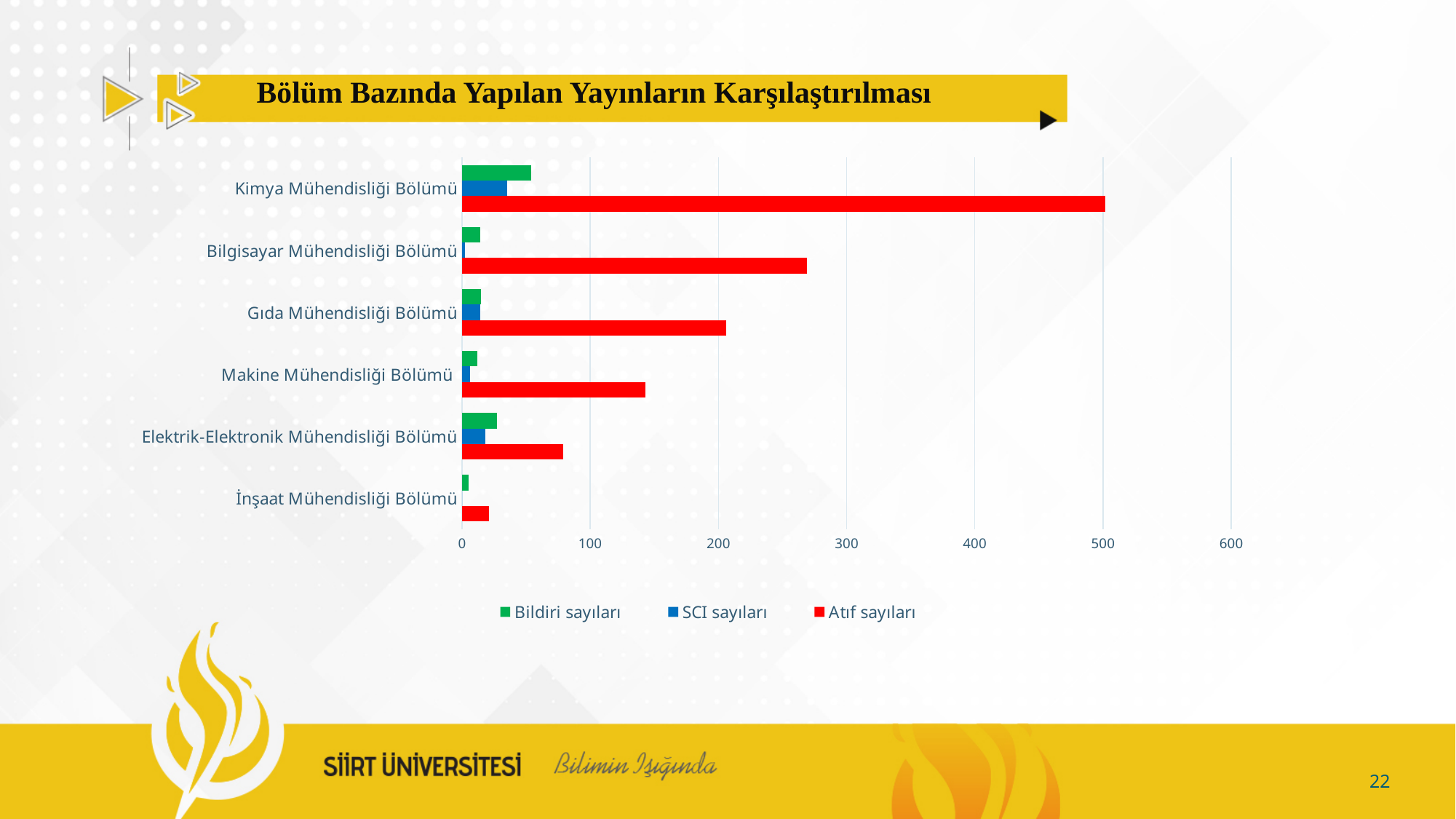
What kind of chart is shown on the slide? bar chart Is the Atıf sayıları value for Kimya Mühendisliği Bölümü greater or less than 400? greater How many departments (categories) are shown on the chart? 6 What is the title of the chart on the slide? Bölüm Bazında Yapılan Yayınların Karşılaştırılması Which department has the highest Bildiri sayıları value? Kimya Mühendisliği Bölümü Is the Atıf sayıları value for Makine Mühendisliği Bölümü greater or less than 200? less Is the Atıf sayıları value for Bilgisayar Mühendisliği Bölümü greater or less than 200? greater Which department has the highest Atıf sayıları value? Kimya Mühendisliği Bölümü Which is larger: the Atıf sayıları value for Bilgisayar Mühendisliği Bölümü or for Gıda Mühendisliği Bölümü? Bilgisayar Mühendisliği Bölümü How many series does the legend list? 3 Which department has the lowest Atıf sayıları value? İnşaat Mühendisliği Bölümü